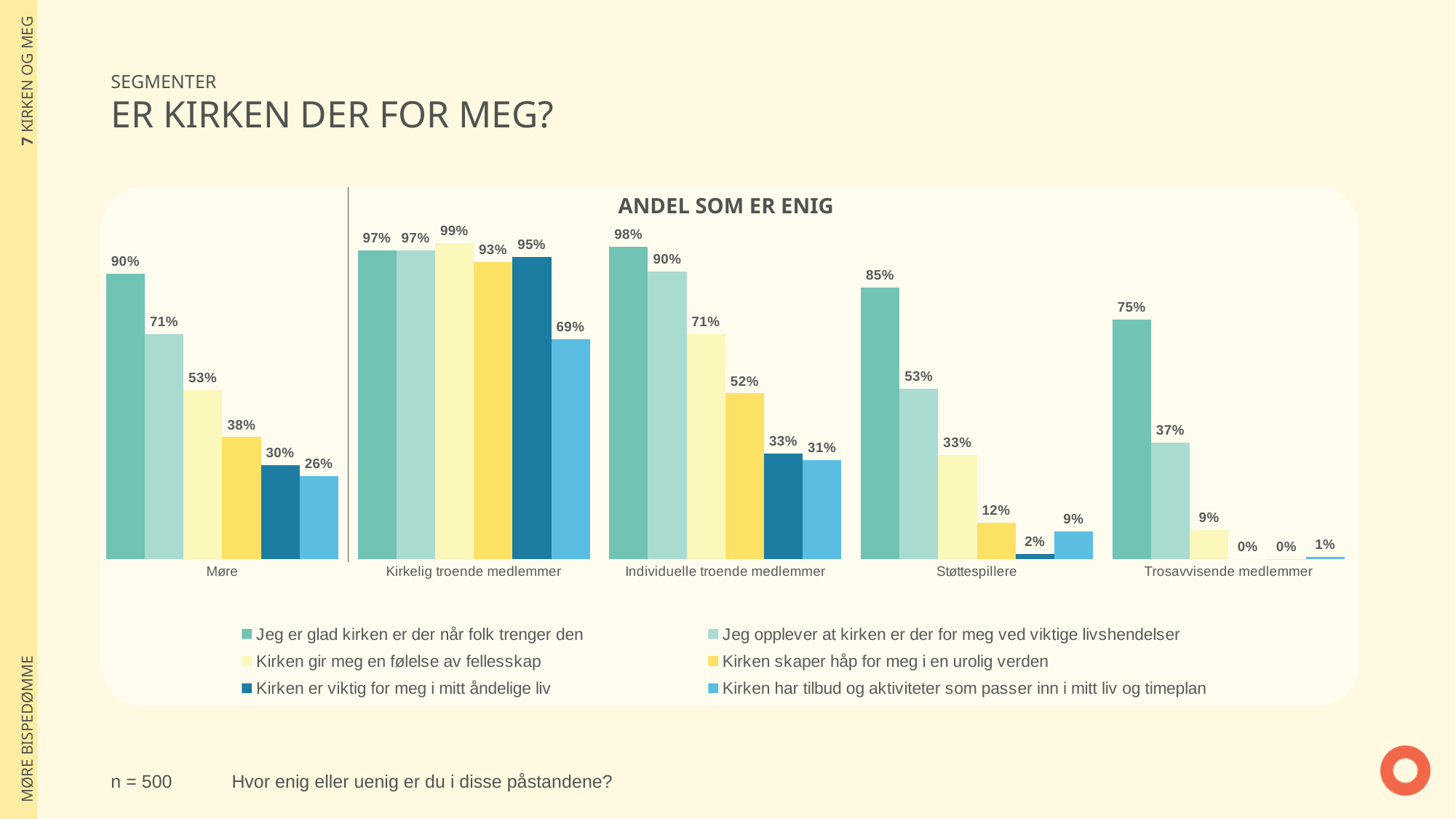
How many series does the legend list? 6 What is the value for "Jeg opplever at kirken er der for meg ved viktige livshendelser" among Trosavvisende medlemmer? 37% What is the title shown above the chart? ANDEL SOM ER ENIG Which segment has the highest value for "Jeg er glad kirken er der når folk trenger den"? Individuelle troende medlemmer What is the difference between the Møre value and the Støttespillere value for "Jeg opplever at kirken er der for meg ved viktige livshendelser"? 18% Which is larger among Individuelle troende medlemmer: "Kirken er viktig for meg i mitt åndelige liv" or "Kirken skaper håp for meg i en urolig verden"? Kirken skaper håp for meg i en urolig verden Which segment has the lowest value for "Kirken har tilbud og aktiviteter som passer inn i mitt liv og timeplan"? Trosavvisende medlemmer What is the value for "Kirken gir meg en følelse av fellesskap" in the Møre group? 53% What kind of chart is shown on the slide? Bar chart What is the value for "Kirken skaper håp for meg i en urolig verden" among Støttespillere? 12% What is the value for "Kirken er viktig for meg i mitt åndelige liv" among Kirkelig troende medlemmer? 95% How many segment groups are shown on the x axis? 5